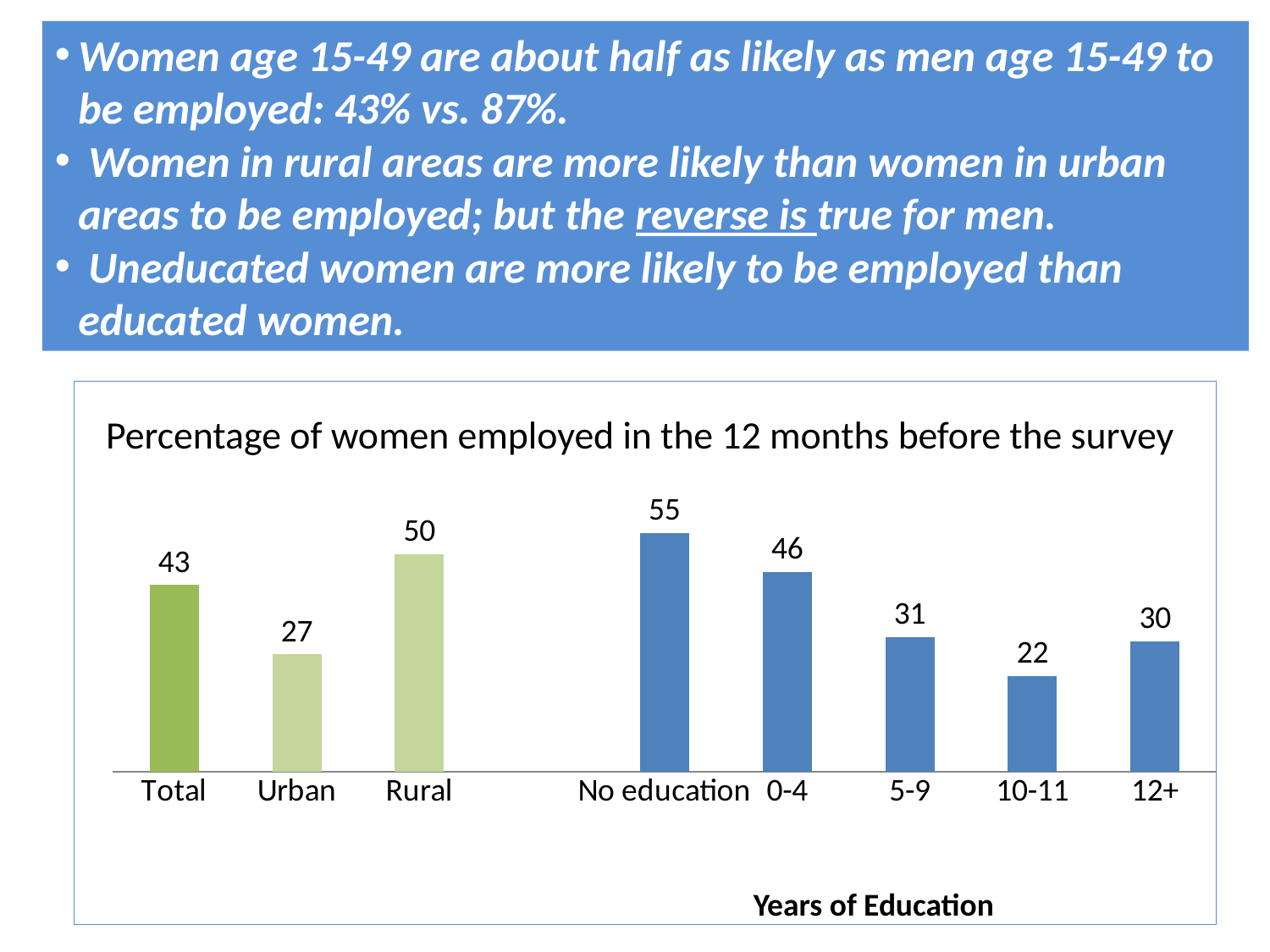
What is the value for Total in the chart? 43 How many bars are plotted in the chart? 8 What is the value for Urban? 27 Which category has the highest value in the chart? No education Which category has the lowest value in the chart? 10-11 What is the title of the chart? Percentage of women employed in the 12 months before the survey Which is larger, the value for 0-4 years of education or the value for 5-9 years? 0-4 What is the difference between the Rural and Urban values? 23 What is the value for women with no education? 55 What is the value for the 10-11 years of education category? 22 What is the difference between the values for No education and 12+? 25 What kind of chart is shown on the slide? Bar chart